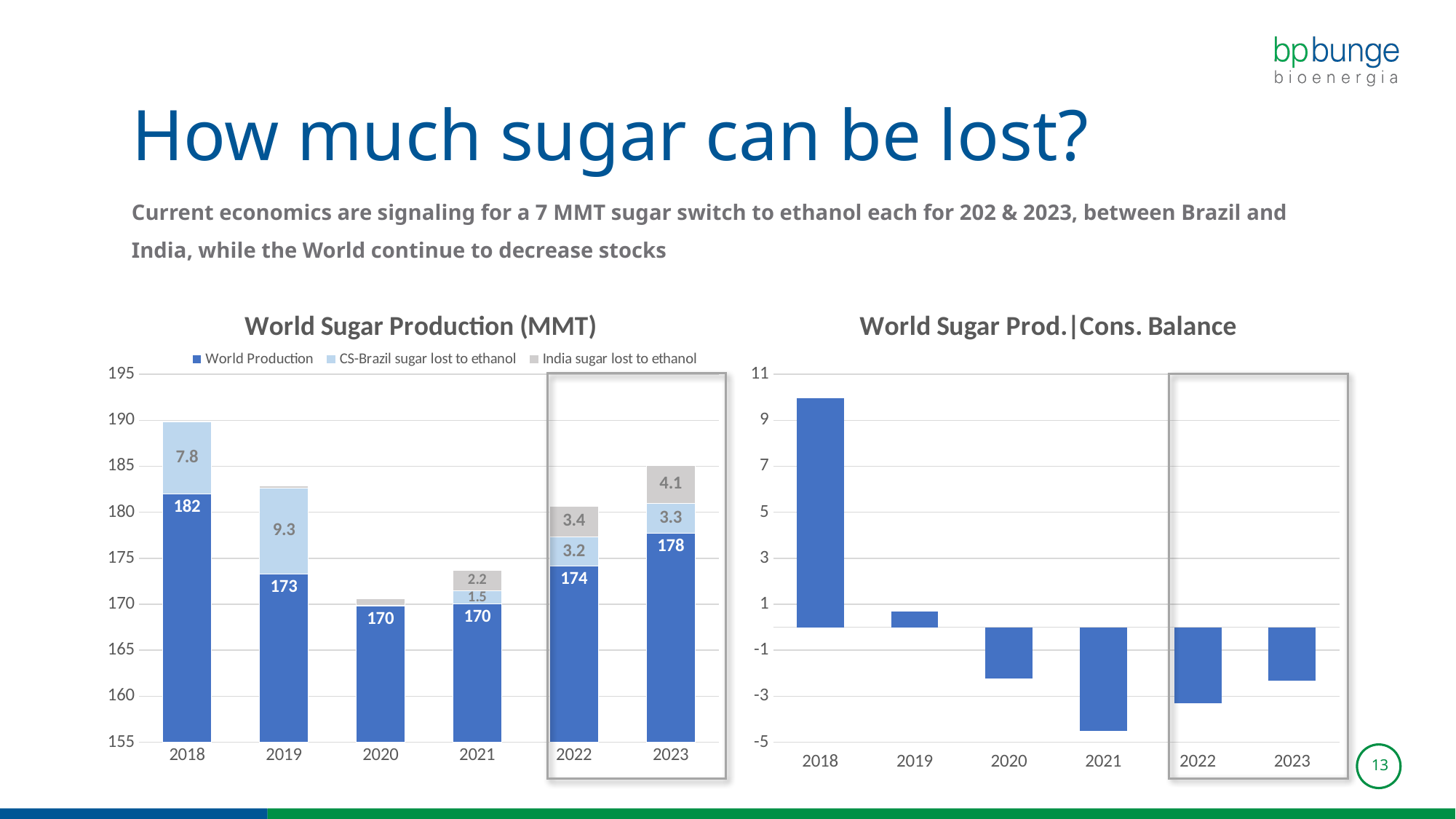
In the World Sugar Production (MMT) chart, which year has the largest CS-Brazil sugar lost to ethanol? 2019 In the World Sugar Production (MMT) chart, how much India sugar is lost to ethanol in 2023? 4.1 In the World Sugar Production (MMT) chart, how much CS-Brazil sugar is lost to ethanol in 2019? 9.3 In the World Sugar Prod.|Cons. Balance chart, which year has the lowest value? 2021 What kind of chart is the World Sugar Prod.|Cons. Balance chart? Bar chart In the World Sugar Production (MMT) chart, what is the total of the stacked bar for 2022? 180.6 In the World Sugar Production (MMT) chart, which is larger in 2022: CS-Brazil sugar lost to ethanol or India sugar lost to ethanol? India sugar lost to ethanol In the World Sugar Prod.|Cons. Balance chart, is the value for 2018 greater or less than 9? greater In the World Sugar Production (MMT) chart, which year has the highest World Production? 2018 In the World Sugar Production (MMT) chart, what is the World Production value for 2018? 182 How many series does the legend of the World Sugar Production (MMT) chart list? 3 In the World Sugar Production (MMT) chart, what is the difference between World Production in 2018 and in 2023? 4